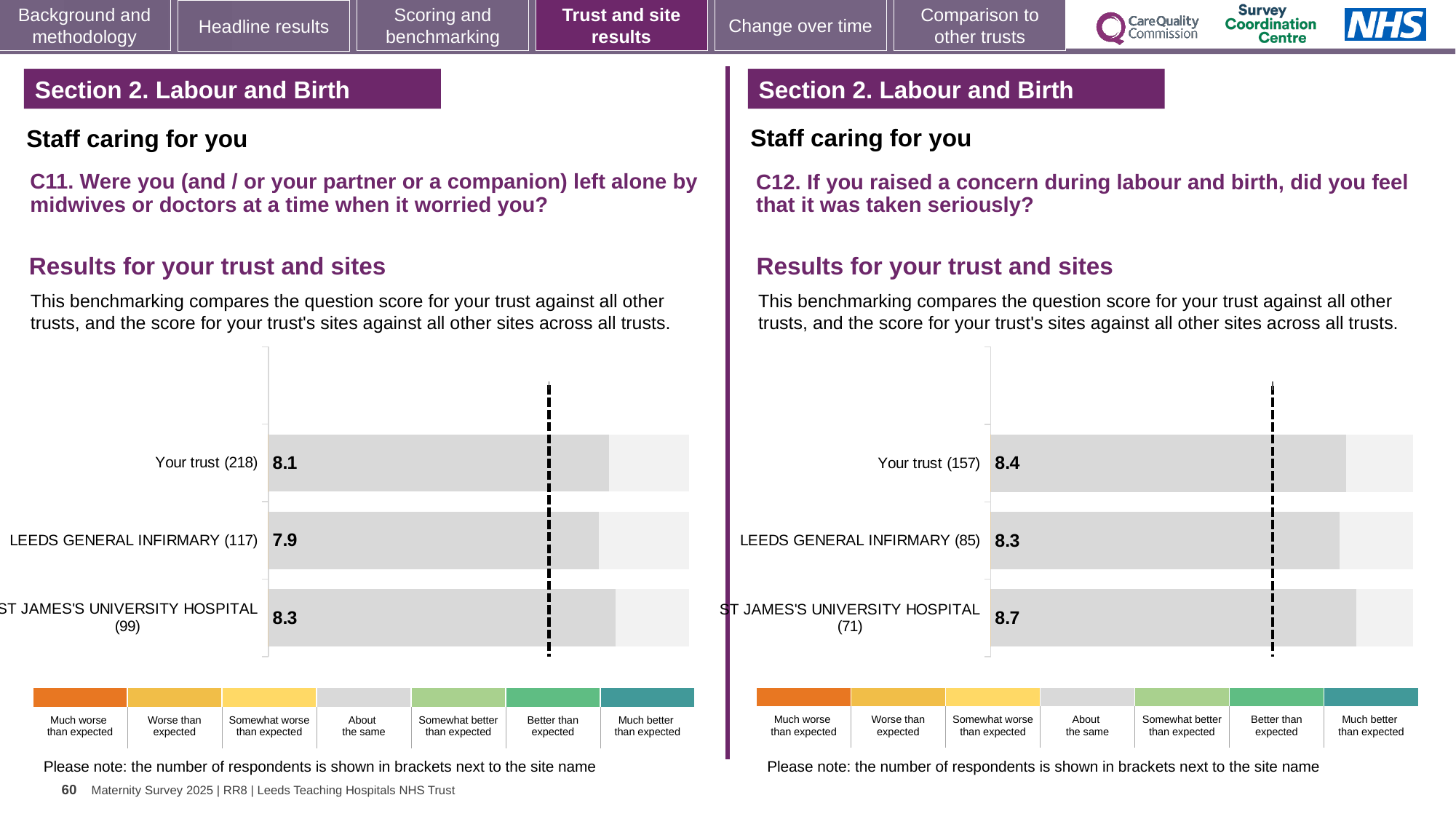
In the C11 chart on the left, what is the score for Your trust? 8.1 In the C11 chart on the left, how many respondents are shown in brackets for ST JAMES'S UNIVERSITY HOSPITAL? 99 How many bars are shown in the C11 chart on the left? 3 In the C12 chart on the right, what is the score for Your trust? 8.4 What type of chart is used in the C12 chart on the right? Bar chart In the C12 chart on the right, which has the higher score, Your trust or LEEDS GENERAL INFIRMARY? Your trust In the C12 chart on the right, which site or trust has the lowest score? LEEDS GENERAL INFIRMARY In the C11 chart on the left, which site or trust has the highest score? ST JAMES'S UNIVERSITY HOSPITAL In the C11 chart on the left, what is the difference between the scores for ST JAMES'S UNIVERSITY HOSPITAL and LEEDS GENERAL INFIRMARY? 0.4 In the C11 chart on the left, what is the score for LEEDS GENERAL INFIRMARY? 7.9 In the C12 chart on the right, what is the score for ST JAMES'S UNIVERSITY HOSPITAL? 8.7 In the C12 chart on the right, what is the difference between the scores for ST JAMES'S UNIVERSITY HOSPITAL and Your trust? 0.3